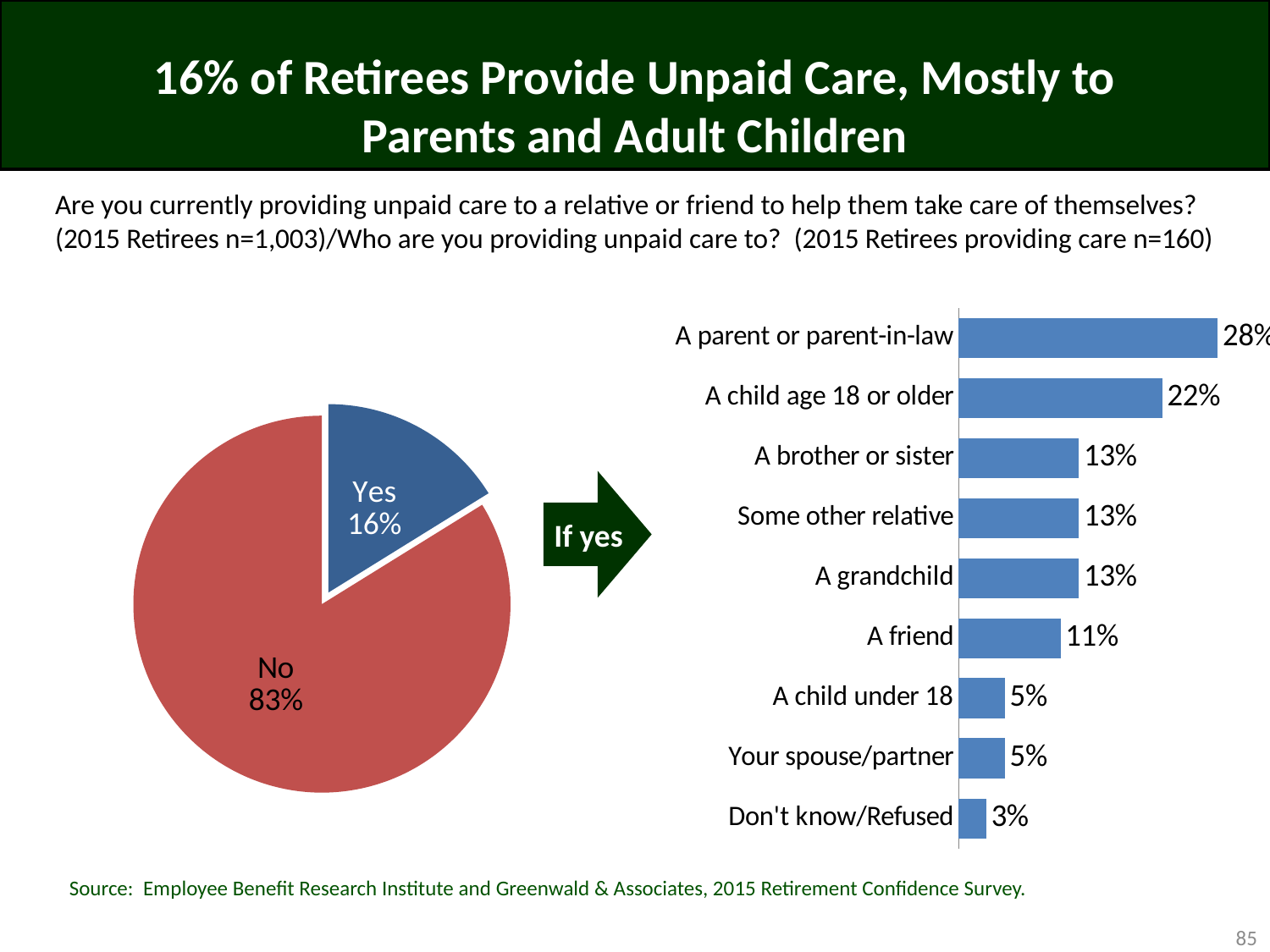
In the bar chart on the right, what is the difference between A parent or parent-in-law and A child age 18 or older? 6% In the bar chart on the right, which category has the highest value? A parent or parent-in-law How many categories are shown in the bar chart on the right? 9 In the pie chart on the left, what share of retirees answered Yes? 16% What kind of chart is the chart on the right of the slide? bar chart What kind of chart is the chart on the left of the slide? pie chart In the pie chart on the left, what share of retirees answered No? 83% In the bar chart on the right, which category has the lowest value? Don't know/Refused In the bar chart on the right, what is the value for Your spouse/partner? 5% In the bar chart on the right, which is larger: A brother or sister or A friend? A brother or sister In the bar chart on the right, what is the value for A child age 18 or older? 22% In the bar chart on the right, what is the value for A friend? 11%